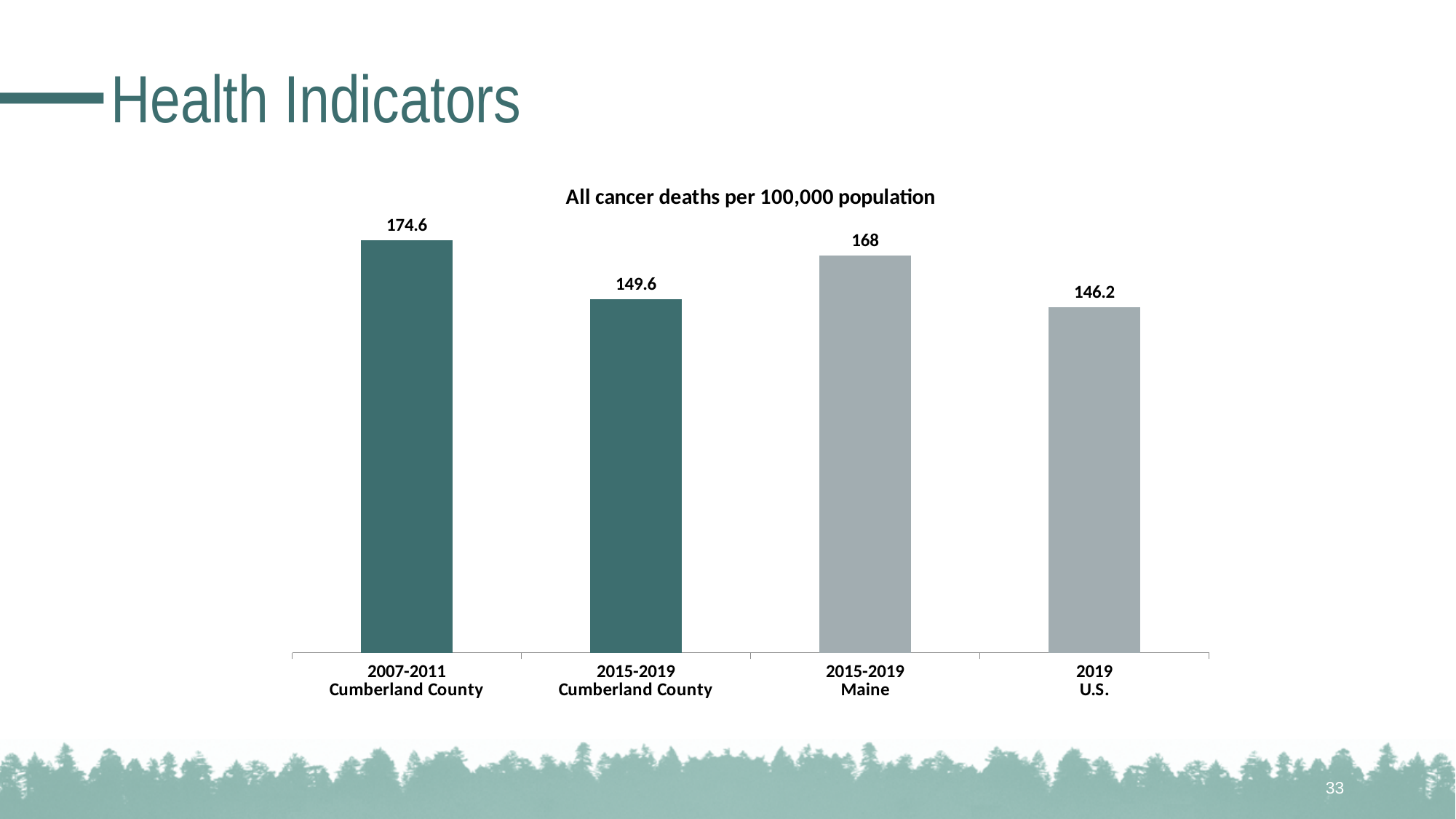
Which category has the highest value? 2007-2011 Cumberland County What kind of chart is shown on the slide? Bar chart What is the difference between the 2015-2019 Maine value and the 2015-2019 Cumberland County value? 18.4 Which category has the lowest value? 2019 U.S. What is the value for 2019 U.S.? 146.2 What is the value for 2007-2011 Cumberland County? 174.6 What is the value for 2015-2019 Cumberland County? 149.6 How many categories are shown in the chart? 4 What is the value for 2015-2019 Maine? 168 Which is larger, the value for 2015-2019 Maine or the value for 2015-2019 Cumberland County? 2015-2019 Maine What is the title of the chart? All cancer deaths per 100,000 population What is the difference between the 2007-2011 Cumberland County value and the 2015-2019 Cumberland County value? 25